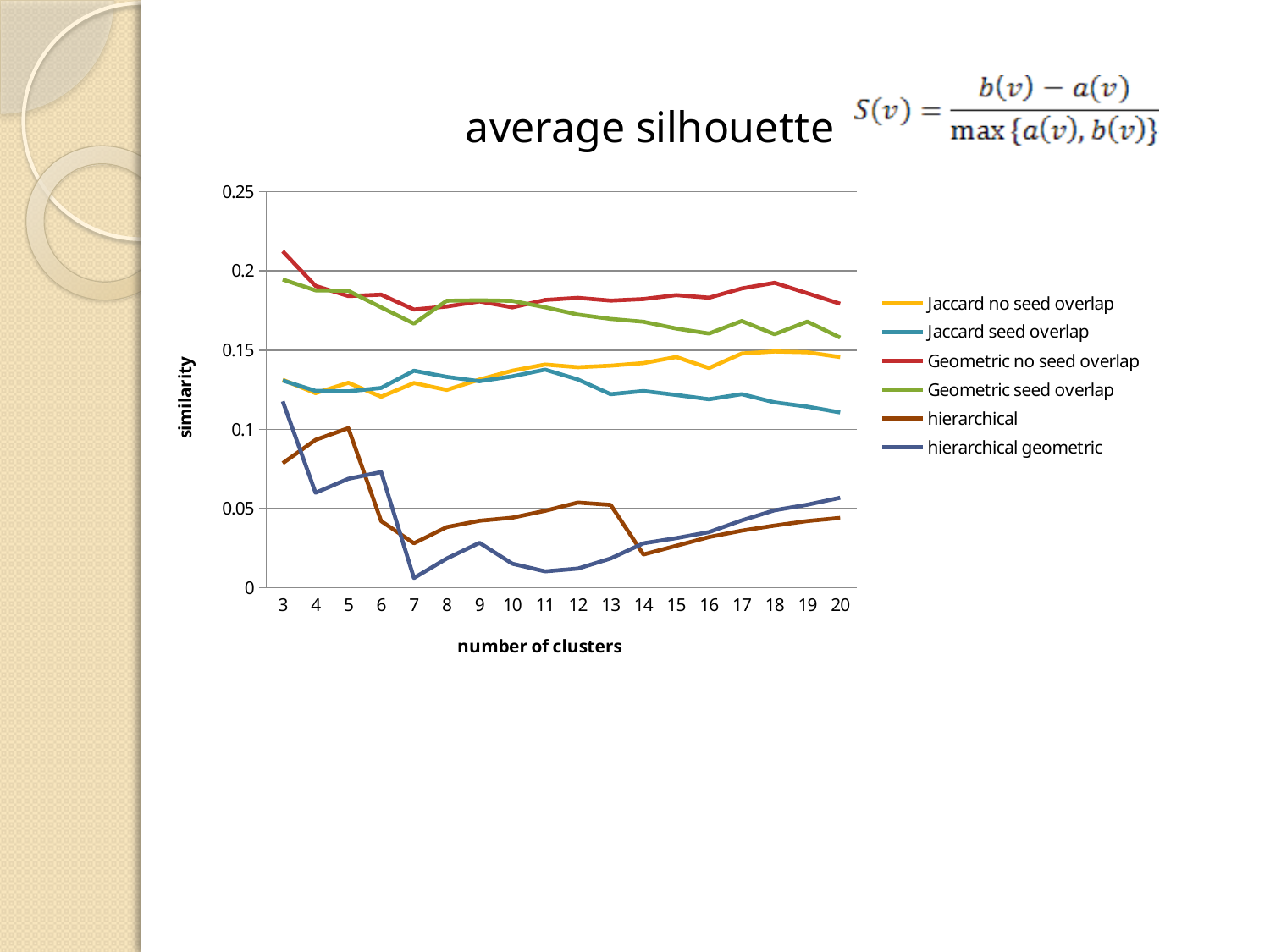
Which series has the highest value at 3 clusters? Geometric no seed overlap Is the value for Jaccard no seed overlap at 17 clusters greater or less than 0.1? greater What kind of chart is shown on the slide? line chart Does the hierarchical geometric series rise or fall from 11 to 20 clusters? rise What is the label on the y axis of the chart? similarity How many values of number of clusters are plotted along the x axis? 18 Does the Jaccard seed overlap series rise or fall from 11 to 20 clusters? fall Which series has the lowest value at 7 clusters? hierarchical geometric Is the value for hierarchical geometric at 7 clusters greater or less than 0.05? less Is the value for Geometric no seed overlap at 3 clusters greater or less than 0.2? greater At 20 clusters, which is larger: Jaccard no seed overlap or Jaccard seed overlap? Jaccard no seed overlap How many series does the legend list? 6